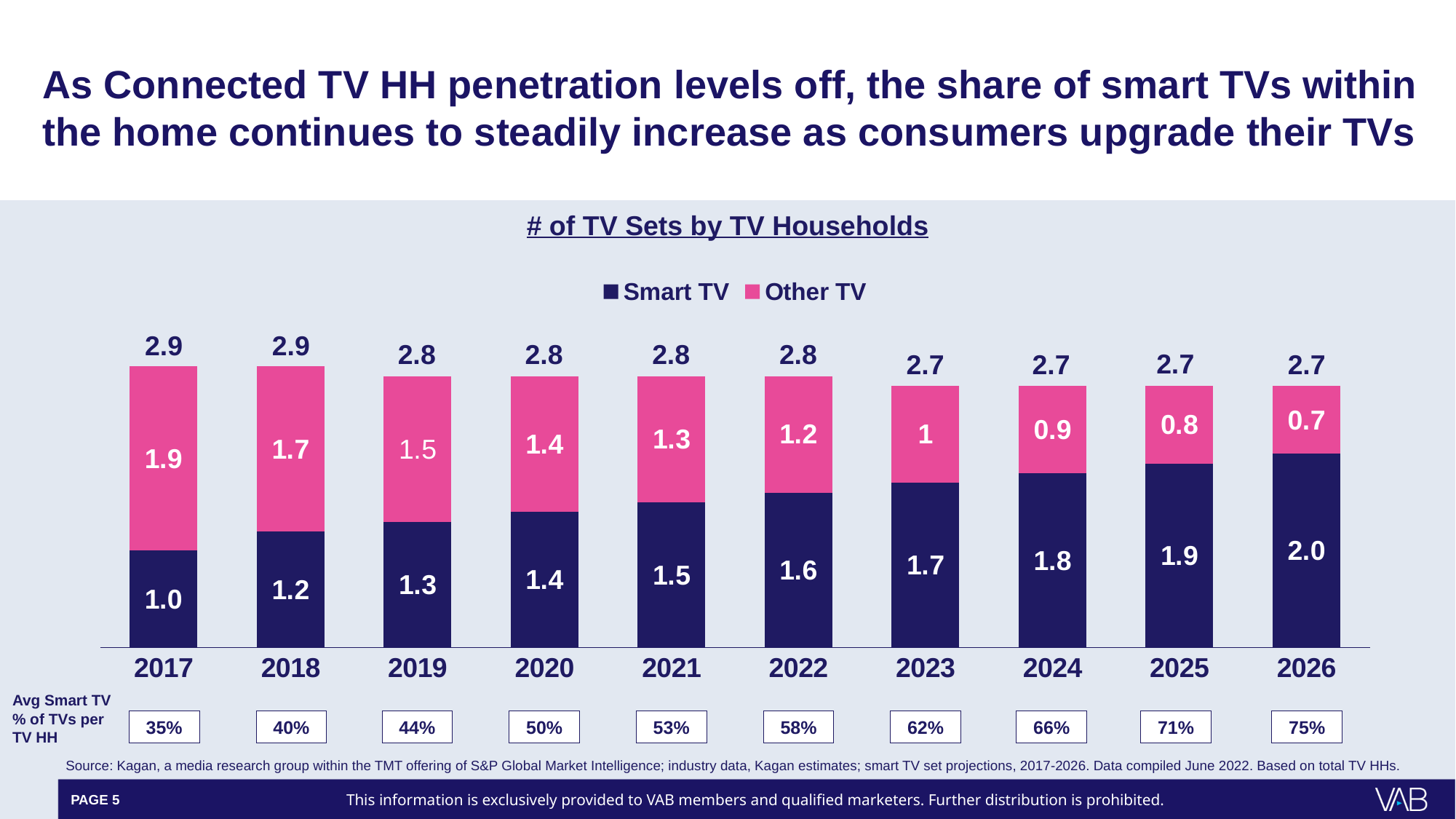
Which year has the highest Other TV value? 2017 What kind of chart is this? Stacked bar chart Which is larger in 2020, the Smart TV value or the Other TV value? They are equal (1.4) What is the Smart TV value for 2026? 2.0 What is the total number of TV sets per household shown for 2019? 2.8 Does the Smart TV value rise or fall from 2017 to 2026? Rise How many series does the legend list? 2 Which year has the lowest Smart TV value? 2017 What is the difference between the Smart TV value in 2026 and the Smart TV value in 2017? 1.0 What is the Smart TV value for 2017? 1.0 How many years are shown on the x axis? 10 What is the Other TV value for 2022? 1.2